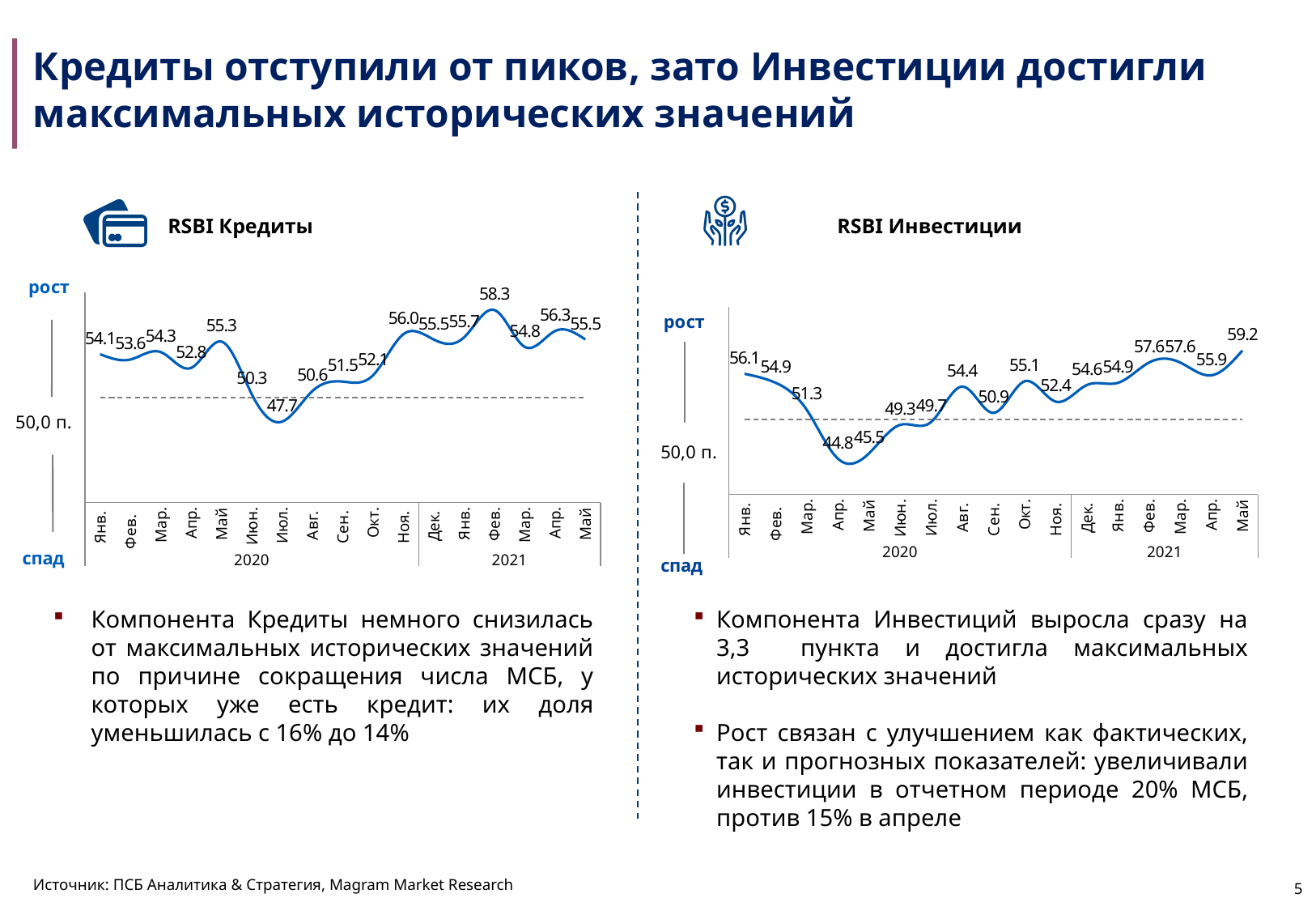
On the RSBI Кредиты chart, which month has the highest value? Фев. 2021 On the RSBI Инвестиции chart, what is the value for Апр. 2020? 44.8 On the RSBI Инвестиции chart, which month has the lowest value? Апр. 2020 On the RSBI Кредиты chart, what is the difference between the values for Фев. 2021 and Май 2021? 2.8 On the RSBI Инвестиции chart, which is larger, the value for Авг. 2020 or the value for Сен. 2020? Авг. 2020 How many data points are plotted on the RSBI Инвестиции chart? 17 What type of chart is the RSBI Кредиты chart? Line chart On the RSBI Кредиты chart, which month has the lowest value? Июл. 2020 On the RSBI Кредиты chart, what is the value for Фев. 2021? 58.3 On the RSBI Инвестиции chart, what is the difference between the values for Май 2021 and Апр. 2021? 3.3 On the RSBI Инвестиции chart, what is the value for Май 2021? 59.2 On the RSBI Кредиты chart, what is the value for Июл. 2020? 47.7